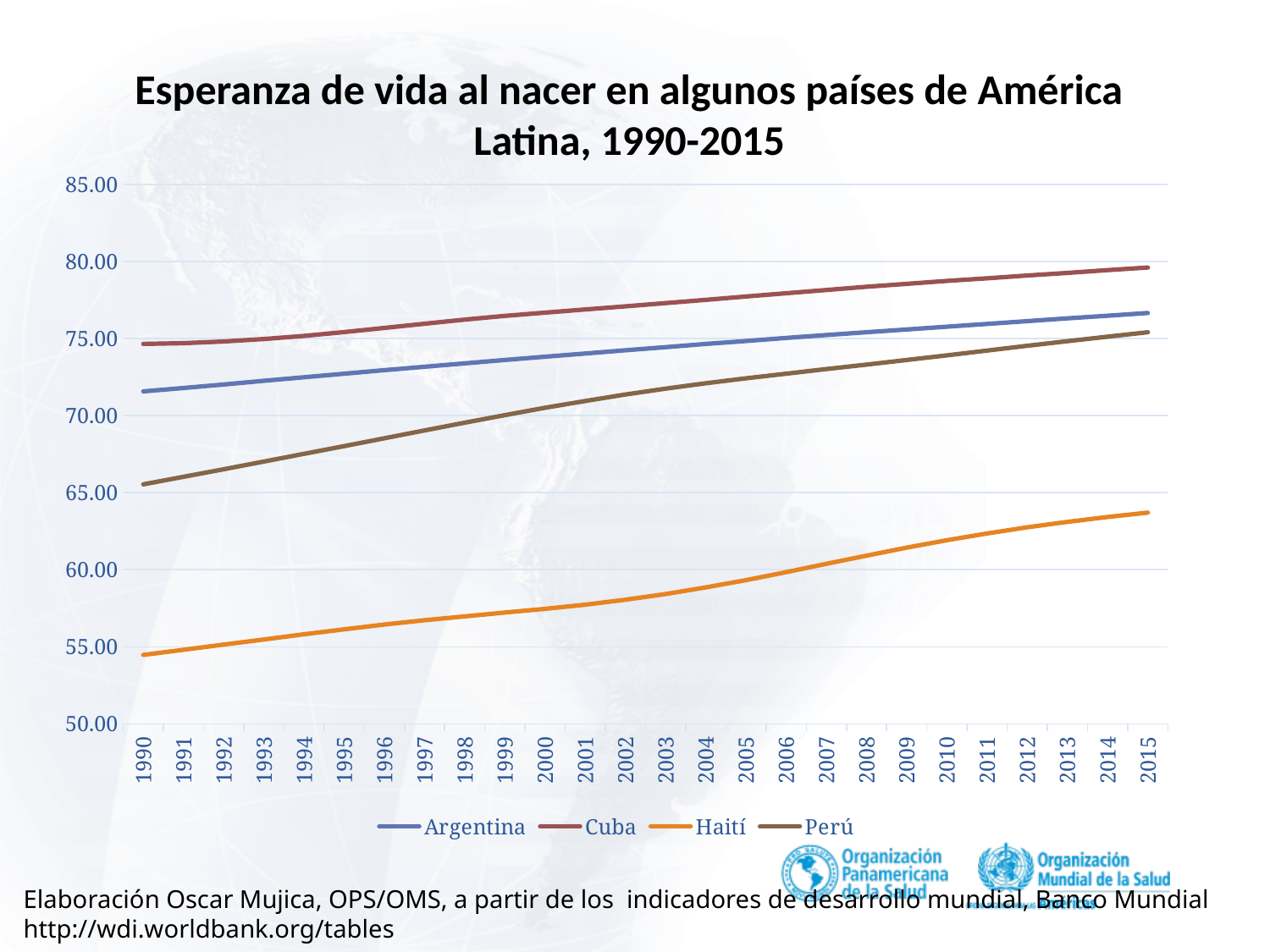
Which series is drawn in orange? Haití Is the value for Haití in 2000 greater or less than 60? less Is the value for Argentina in 1990 greater or less than 70? greater Is the value for Cuba in 2005 greater or less than 75? greater In 1990, which is larger, the value for Argentina or the value for Perú? Argentina How many years are shown along the x axis? 26 Do the values for Haití rise or fall from 1990 to 2015? rise What kind of chart is shown on the slide? line chart Which country has the highest life expectancy in 2015? Cuba Which country has the lowest life expectancy throughout the period? Haití How many series does the legend list? 4